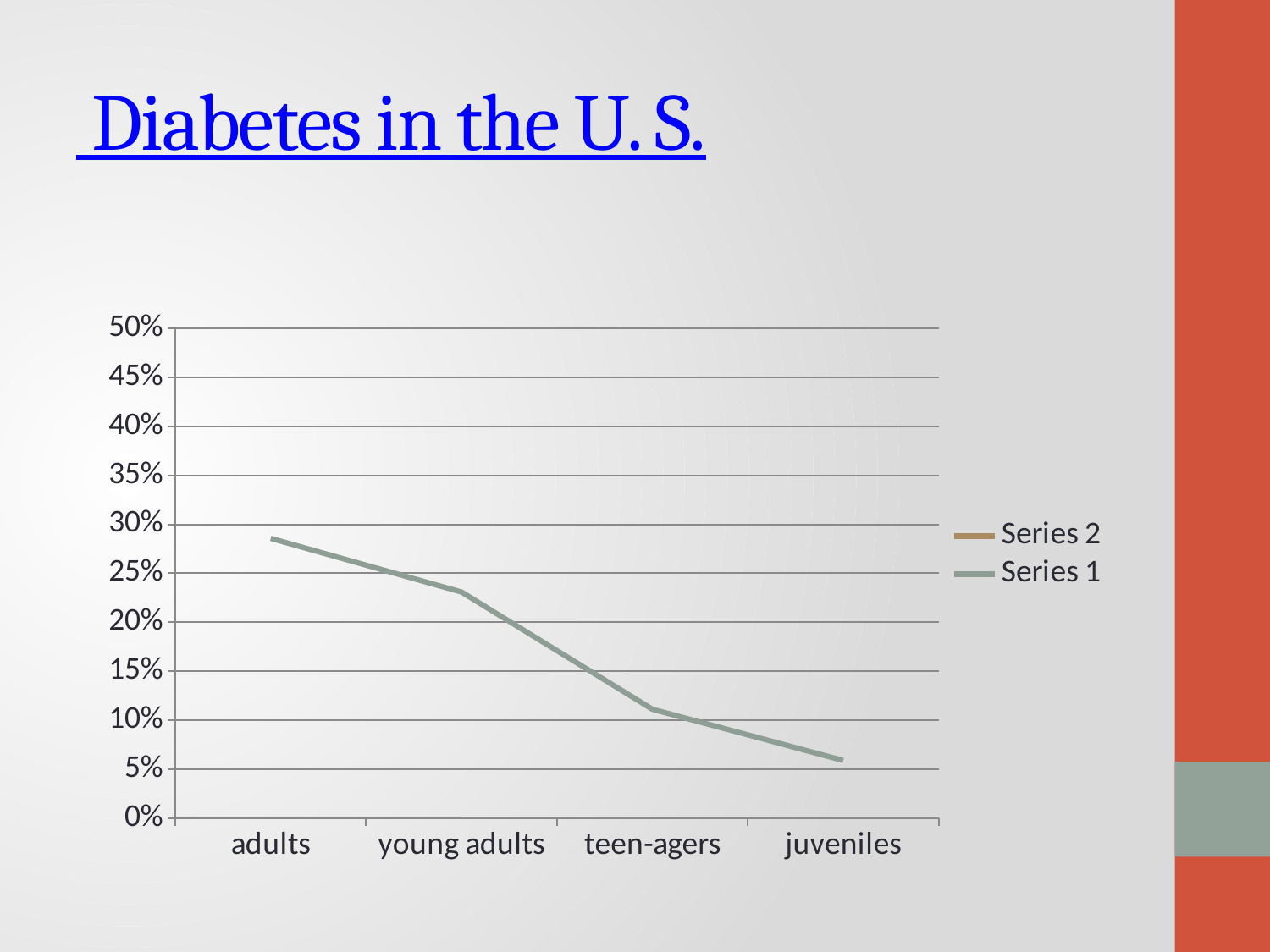
Which has a larger Series 1 value, young adults or teen-agers? young adults What kind of chart is shown on the slide? line chart Is the Series 1 value for adults greater or less than 25%? greater Which category has the highest value for Series 1? adults Is the Series 1 value for teen-agers greater or less than 15%? less Which category has the lowest value for Series 1? juveniles How many categories are shown on the x axis of the chart? 4 Do the Series 1 values rise or fall from adults to juveniles along the x axis? fall Is the Series 1 value for juveniles greater or less than 10%? less What is the title of the slide containing the chart? Diabetes in the U.S. How many series does the chart's legend list? 2